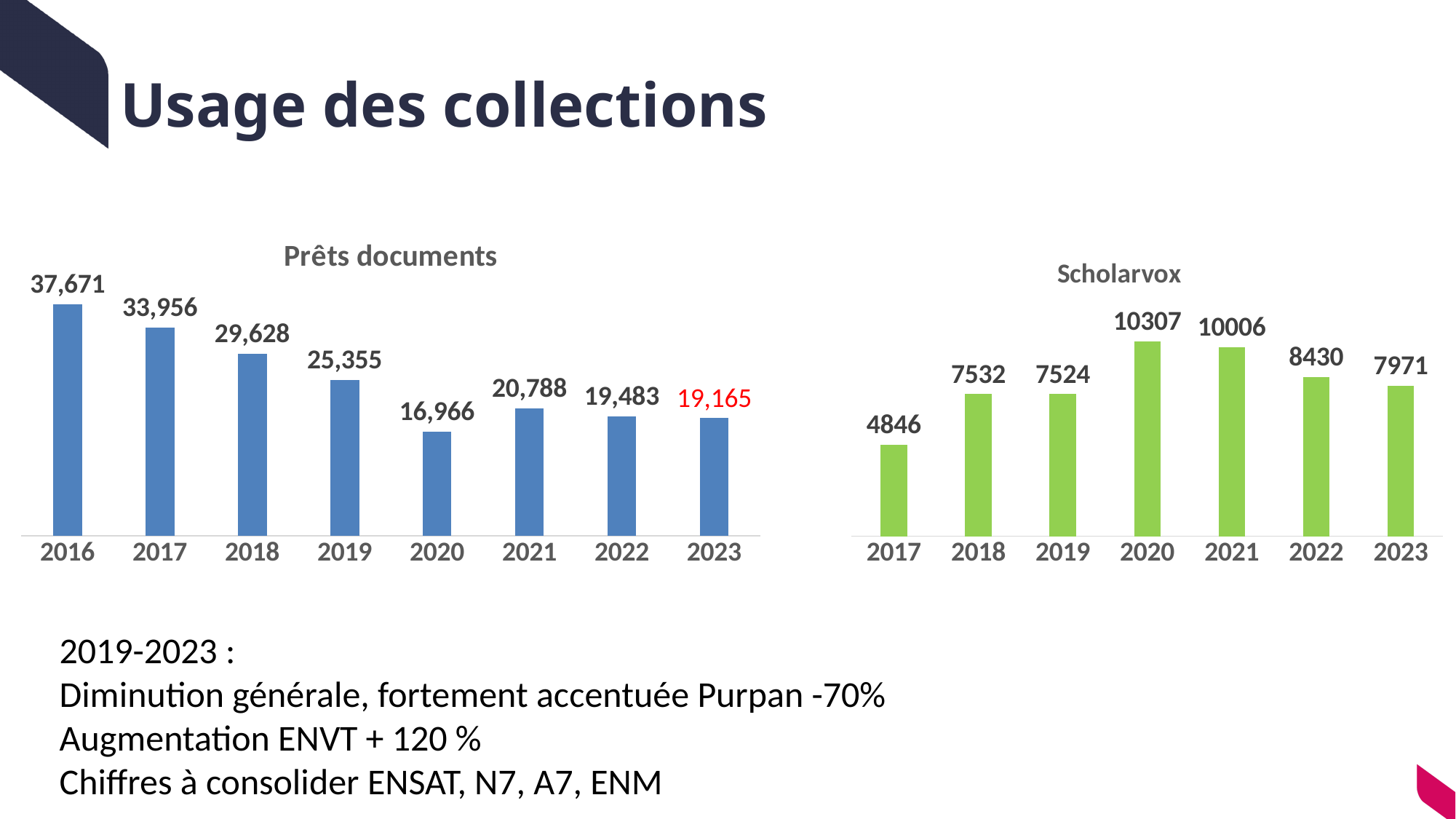
In the 'Scholarvox' chart, which year has the highest value? 2020 In the 'Scholarvox' chart, what is the difference between the 2022 and 2023 values? 459 In the 'Prêts documents' chart, what is the value for 2023? 19,165 In the 'Prêts documents' chart, which year has the lowest value? 2020 In the 'Prêts documents' chart, what is the value for 2016? 37,671 What type of chart is the 'Scholarvox' chart? bar chart In the 'Scholarvox' chart, which is larger, the value for 2018 or the value for 2022? 2022 In the 'Scholarvox' chart, what is the value for 2020? 10307 In the 'Scholarvox' chart, which year has the lowest value? 2017 In the 'Prêts documents' chart, what is the difference between the 2016 and 2023 values? 18,506 In the 'Prêts documents' chart, do the values generally rise or fall from 2016 to 2020? fall In the 'Prêts documents' chart, how many years are shown? 8